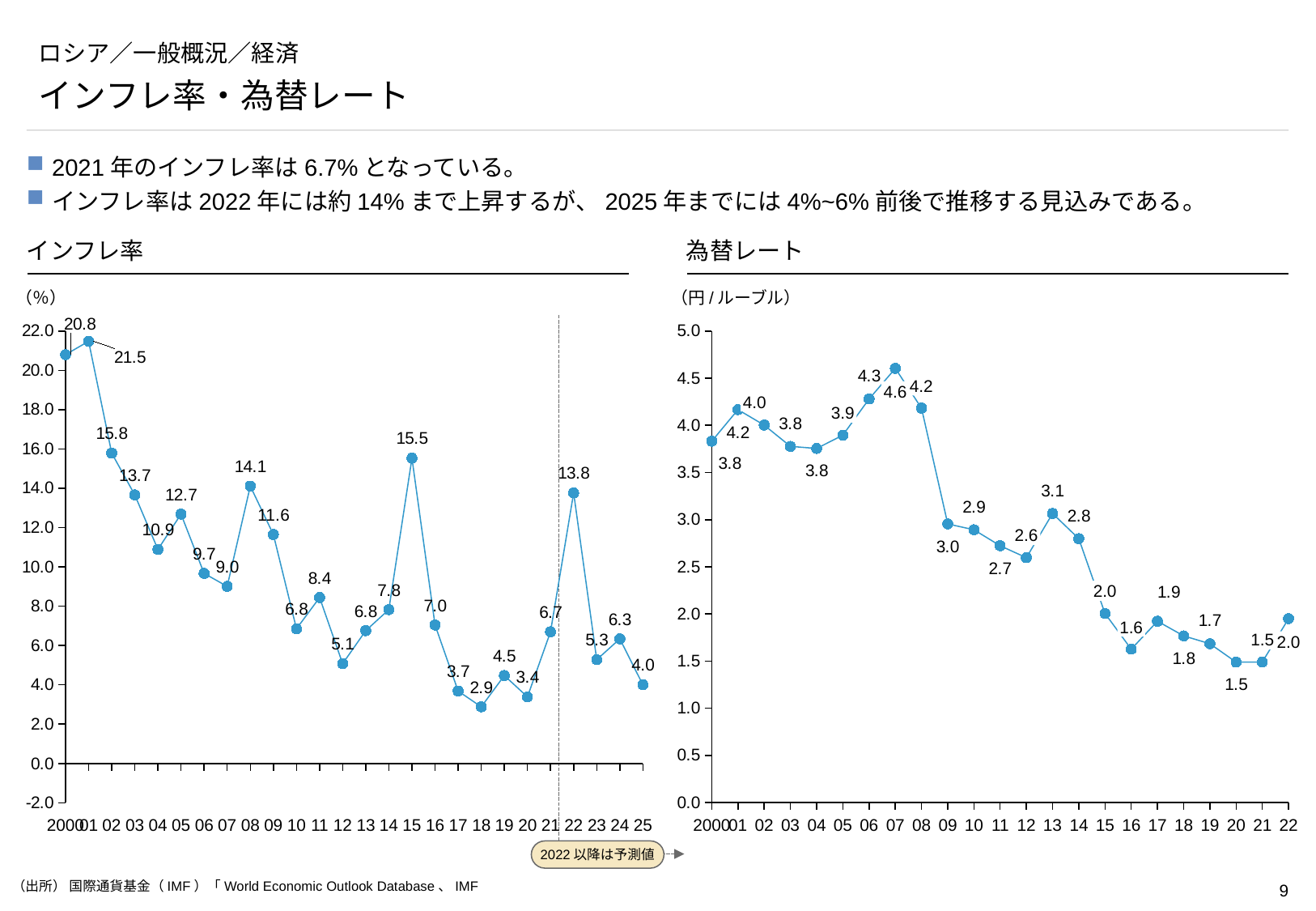
On the インフレ率 chart, what is the value for 2015? 15.5 On the 為替レート chart, which year has the highest value? 2007 What kind of chart is the 為替レート chart? line chart On the 為替レート chart, is the value for 2013 larger or the value for 2014? 2013 On the インフレ率 chart, what is the difference between the 2022 value and the 2021 value? 7.1 On the インフレ率 chart, which year has the lowest inflation rate? 2018 What unit is shown on the y axis of the 為替レート chart? 円/ルーブル On the 為替レート chart, what is the value for 2007? 4.6 On the インフレ率 chart, which year has the highest inflation rate? 2001 On the インフレ率 chart, what is the inflation rate for 2021? 6.7 On the 為替レート chart, what is the difference between the 2008 value and the 2009 value? 1.2 On the インフレ率 chart, how many data points are plotted? 26